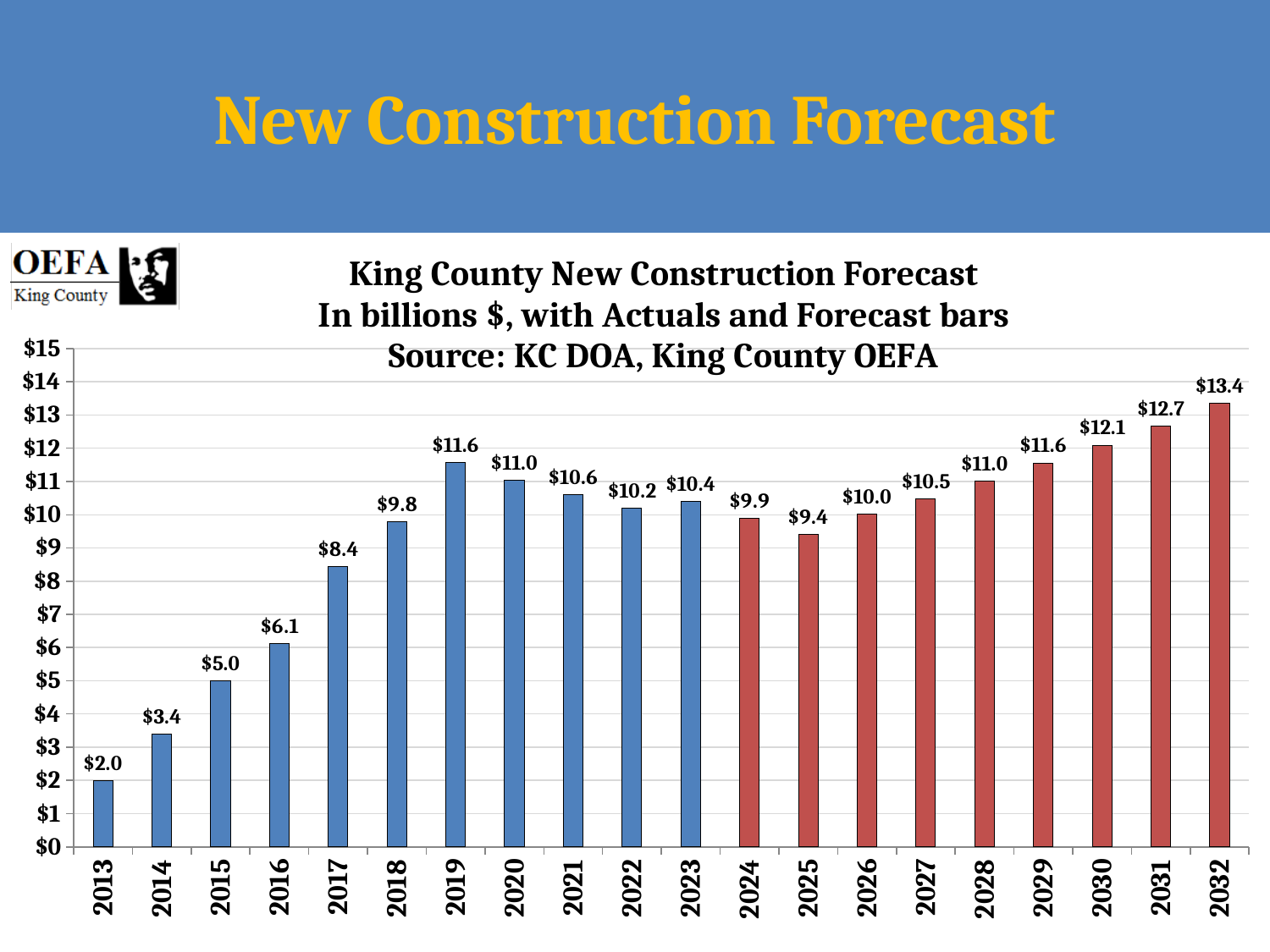
What is the source listed in the chart title? KC DOA, King County OEFA Is the value for 2017 greater or less than $8? greater How many years are shown on the x axis? 20 What is the value for 2013? $2.0 What is the difference between the values for 2032 and 2013? $11.4 Which year has the lowest value? 2013 Which year has the highest value? 2032 Which is larger, the value for 2020 or the value for 2024? 2020 Do the values rise or fall from 2024 to 2032? Rise What is the value for 2025? $9.4 What is the value for 2019? $11.6 What kind of chart is shown? Bar chart